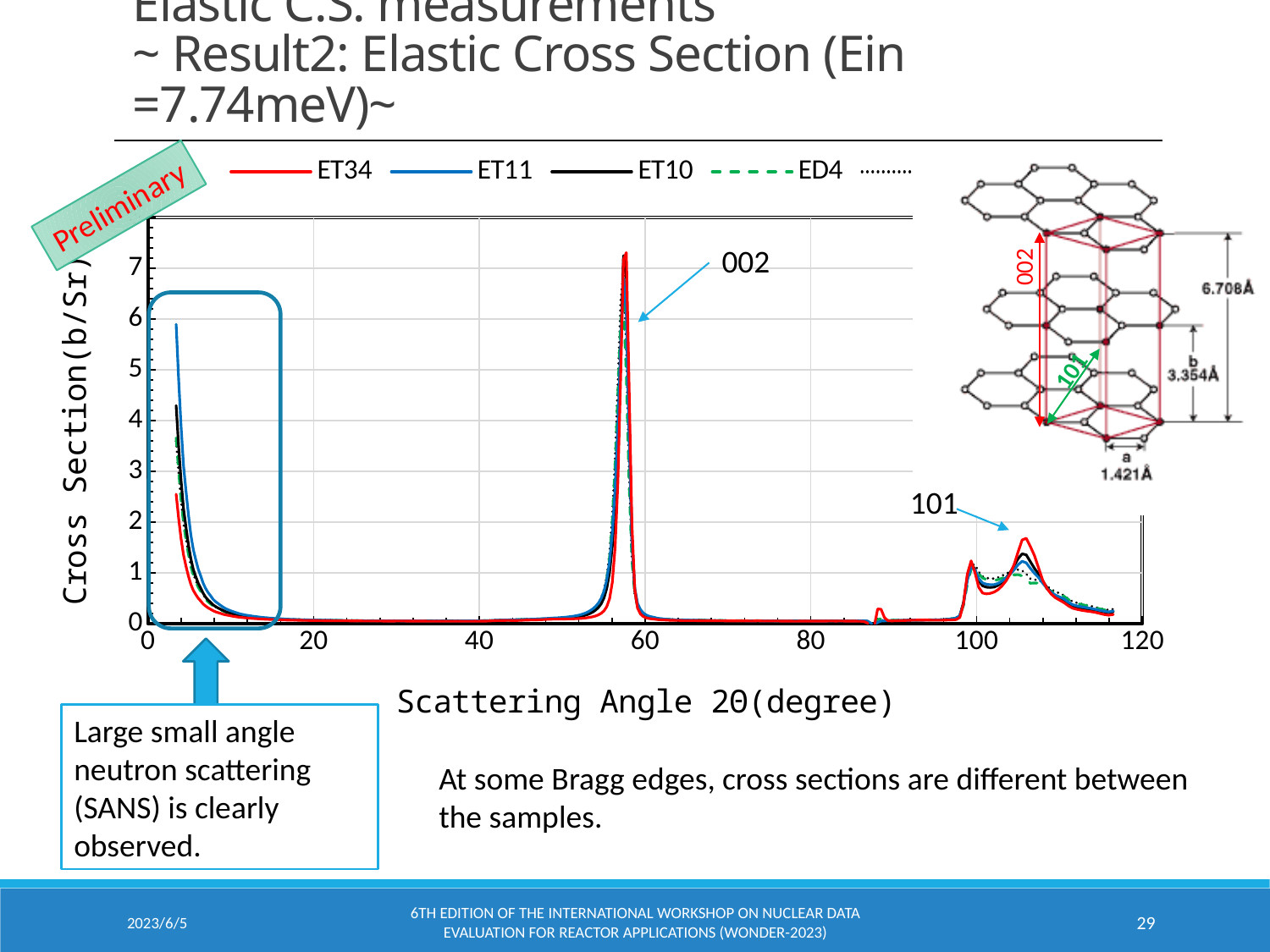
At the 101 peak near 105 degrees, which series has the larger cross section, ET34 or ET11? ET34 Is the peak cross section at the 002 Bragg peak (near 58 degrees) greater or less than 6? greater Is the cross section of ET11 at its smallest plotted scattering angle greater or less than 5? greater Is the cross section at a scattering angle of 40 degrees greater or less than 1? less What is the largest tick value shown on the x axis? 120 At very small scattering angles (below 5 degrees), which series has the larger cross section, ET11 or ET34? ET11 Which labelled Bragg peak, 002 or 101, reaches the higher cross section? 002 What kind of chart is shown on the slide? line chart What is the label of the x axis of the chart? Scattering Angle 2θ(degree) What is the largest tick value shown on the y axis? 7 What is the label of the y axis of the chart? Cross Section(b/Sr)